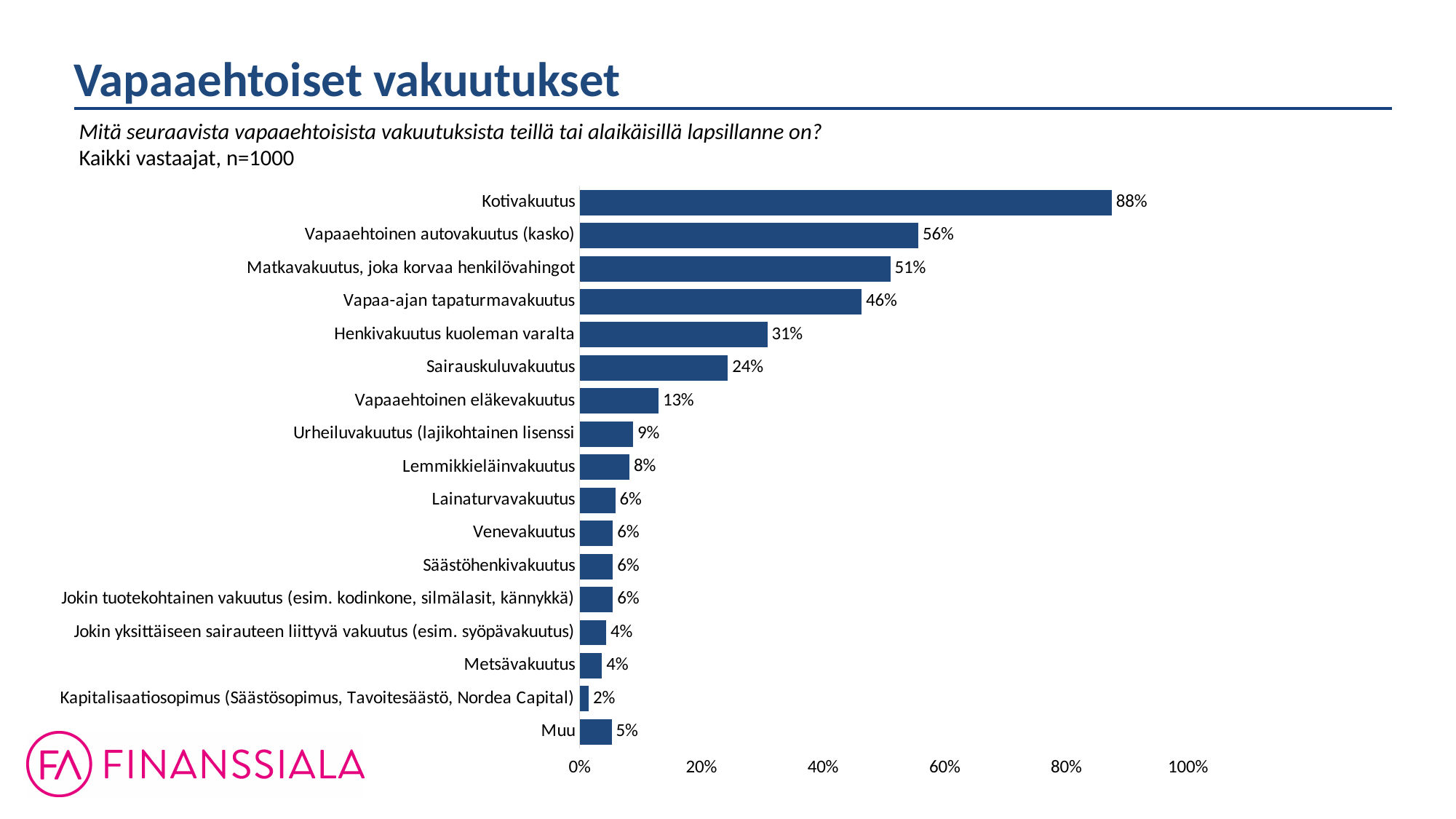
What is the difference between the values for Vapaaehtoinen autovakuutus (kasko) and Matkavakuutus, joka korvaa henkilövahingot? 5% What is the value for Henkivakuutus kuoleman varalta? 31% What is the value for Muu? 5% How many categories are shown in the chart? 17 What is the value for Kotivakuutus? 88% Which category has the highest value? Kotivakuutus Which is larger, the value for Sairauskuluvakuutus or the value for Vapaaehtoinen eläkevakuutus? Sairauskuluvakuutus What is the title of the slide? Vapaaehtoiset vakuutukset What kind of chart is shown on the slide? bar chart Is the value for Vapaa-ajan tapaturmavakuutus greater or less than 40%? greater What is the value for Lemmikkieläinvakuutus? 8% Which category has the lowest value? Kapitalisaatiosopimus (Säästösopimus, Tavoitesäästö, Nordea Capital)